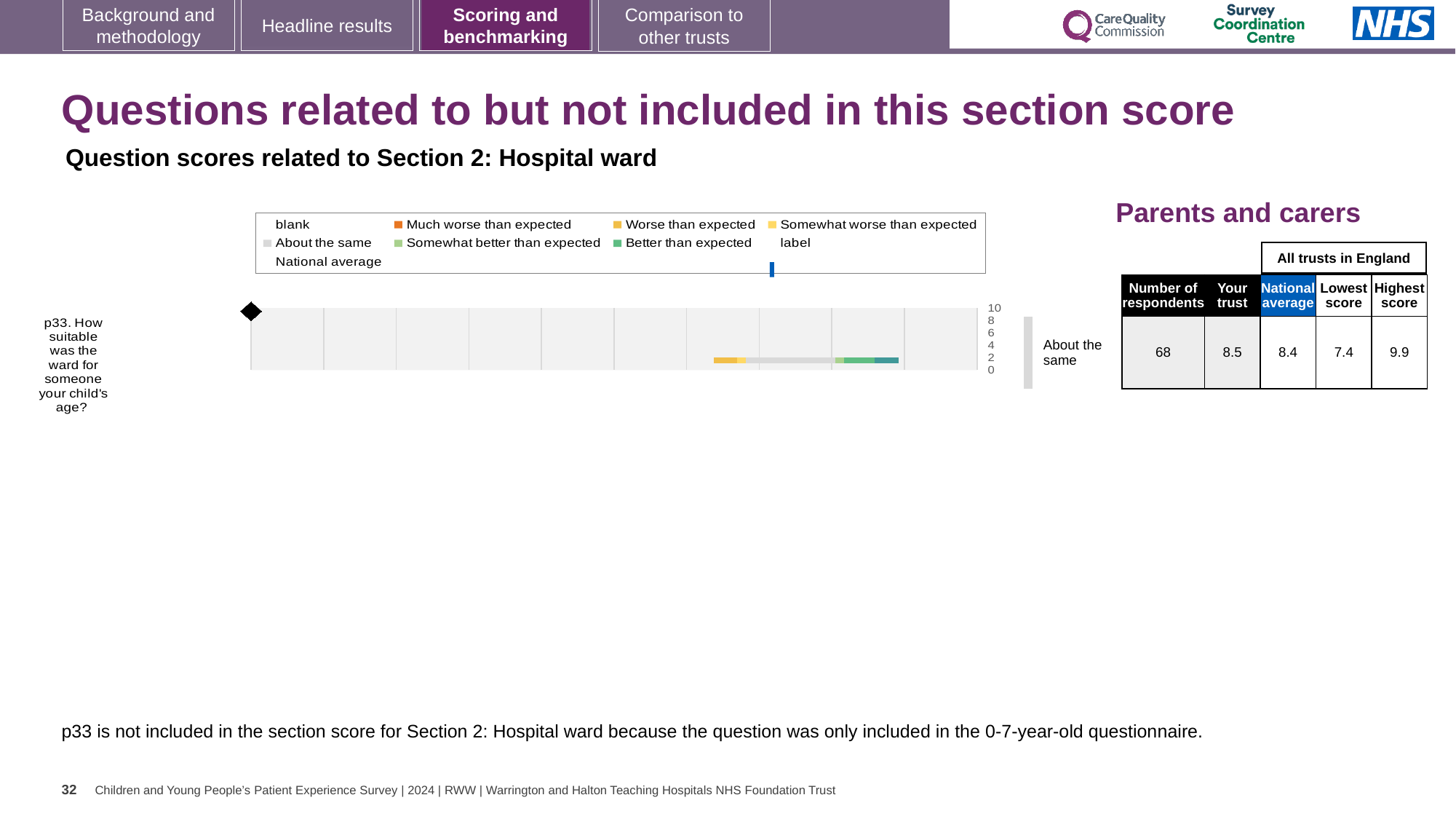
What is the highest value shown on the chart's axis? 10 What is the 'Your trust' score for p33 in the table? 8.5 What is the national average score for p33 in the table? 8.4 How many questions are plotted in the chart? 1 What is the difference between the highest score and the lowest score for p33? 2.5 What is the lowest score among all trusts in England for p33? 7.4 What is the question text plotted in the chart? p33. How suitable was the ward for someone your child's age? What is the highest score among all trusts in England for p33? 9.9 What benchmark category is shown next to the bar for p33? About the same What kind of chart is shown for question p33? bar chart Which is larger for p33, the 'Your trust' score or the national average? Your trust How many respondents answered p33? 68